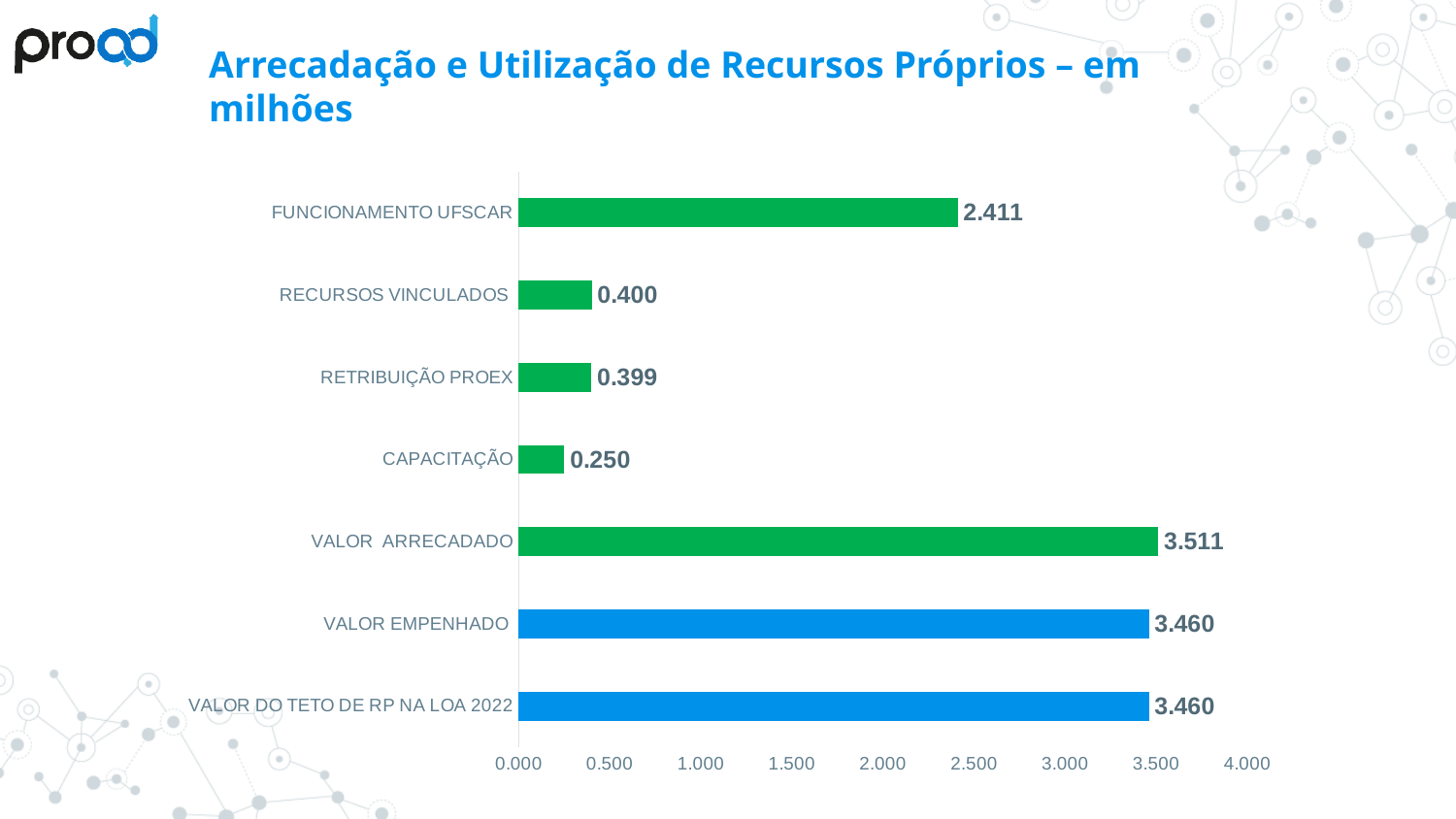
What is the difference between FUNCIONAMENTO UFSCAR and CAPACITAÇÃO? 2.161 What is the value for FUNCIONAMENTO UFSCAR? 2.411 How many categories are shown in the chart? 7 Which category has the highest value? VALOR ARRECADADO What is the value for VALOR DO TETO DE RP NA LOA 2022? 3.460 Which is larger, FUNCIONAMENTO UFSCAR or VALOR EMPENHADO? VALOR EMPENHADO What kind of chart is shown on the slide? bar chart Which category has the lowest value? CAPACITAÇÃO Is the value for FUNCIONAMENTO UFSCAR greater or less than 2.000? greater What is the value for VALOR ARRECADADO? 3.511 What is the difference between VALOR ARRECADADO and VALOR EMPENHADO? 0.051 What is the value for CAPACITAÇÃO? 0.250